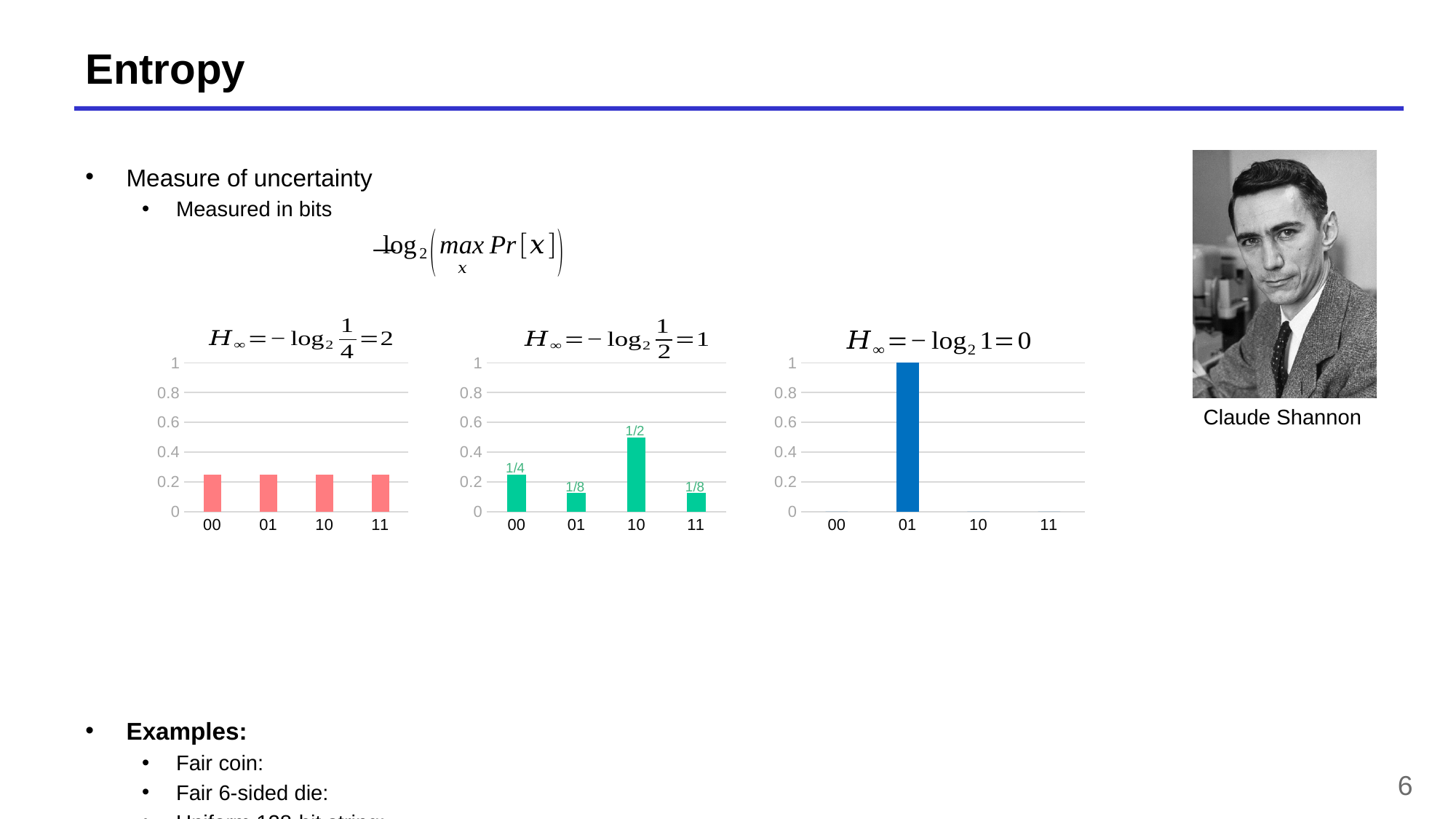
In the middle chart, what is the difference between the value for 10 and the value for 00? 1/4 What kind of chart is the middle chart? bar chart In the middle chart, which category has the highest value? 10 In the middle chart, which is larger, the value for 00 or the value for 01? 00 In the middle chart, what is the value for category 00? 1/4 In the right chart, which category has the highest value? 01 How many categories are shown on the x axis of the left chart? 4 What colour are the bars in the right chart? blue In the left chart, is the value for 00 greater or less than 0.4? less In the middle chart, what is the value for category 10? 1/2 In the right chart, what is the value for category 10? 0 In the right chart, what is the value for category 01? 1